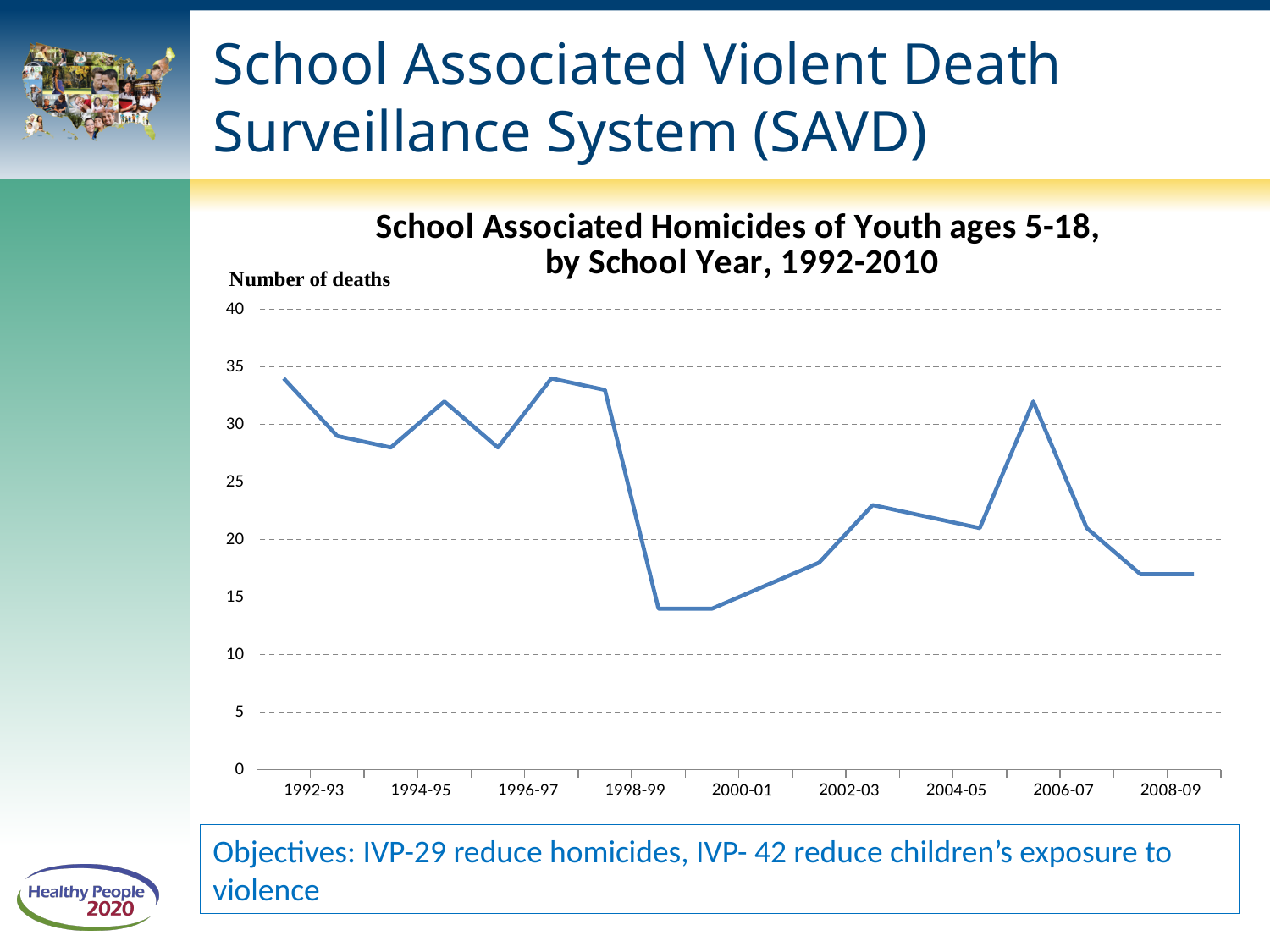
What is the label on the vertical axis of the chart? Number of deaths Which has a higher number of deaths, 1992-93 or 2008-09? 1992-93 Is the value for 1992-93 greater or less than 25? greater Overall, does the number of deaths rise or fall from 1992-93 to 2008-09? fall Is the value for 1996-97 greater or less than 25? greater Is the value for 2000-01 greater or less than 20? less What is the title of the chart? School Associated Homicides of Youth ages 5-18, by School Year, 1992-2010 Which has a higher number of deaths, 1994-95 or 2000-01? 1994-95 What kind of chart is shown on the slide? line chart